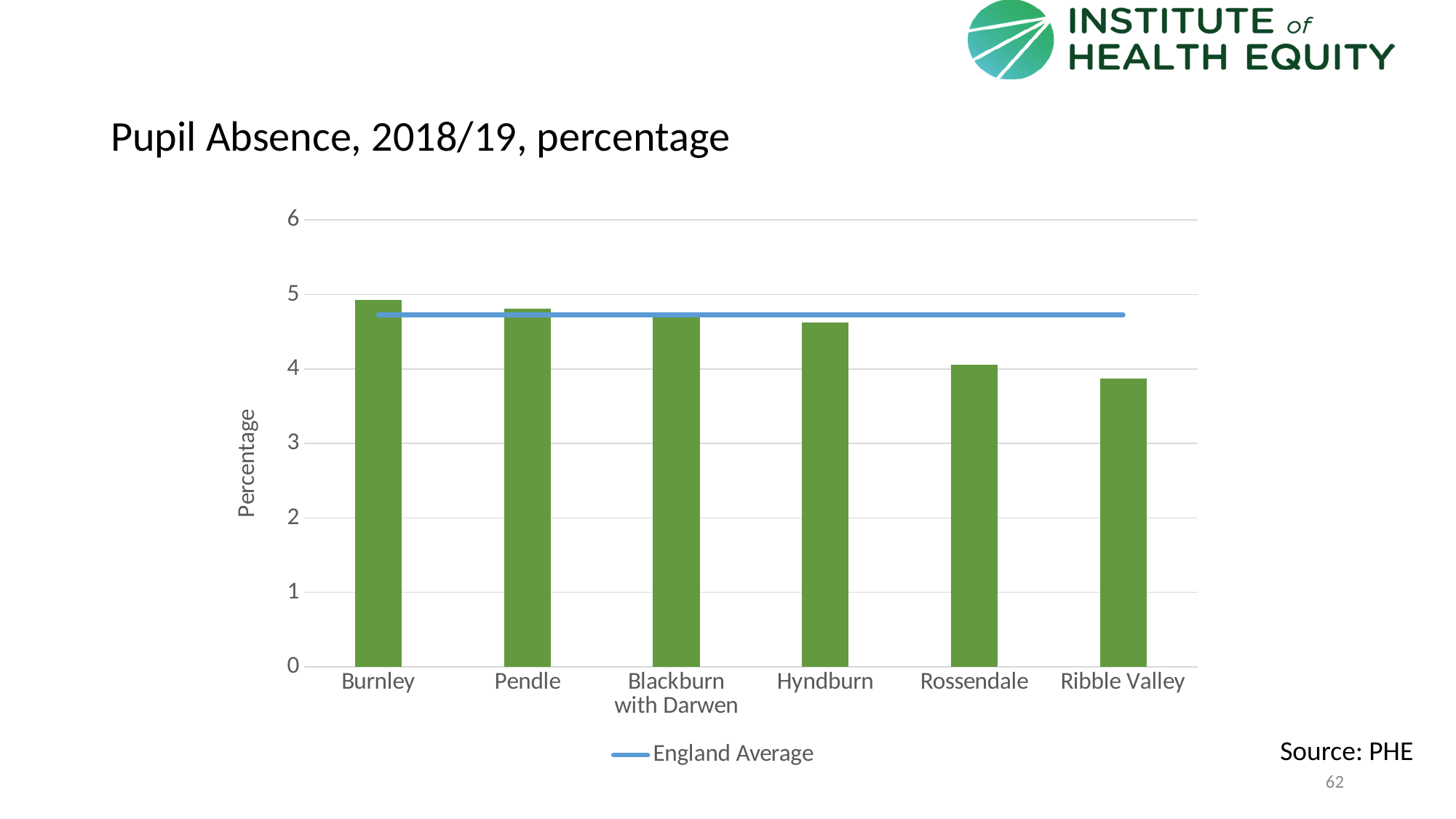
Which is larger, the value for Hyndburn or the value for Rossendale? Hyndburn Which area has the lowest pupil absence percentage? Ribble Valley Is the value for Ribble Valley greater or less than 4? less Is the value for Burnley greater or less than 5? less Do the bar values rise or fall from left to right along the x axis? Fall How many local areas are shown on the x axis of the chart? 6 What kind of chart is shown on the slide? Bar chart Which is larger, the value for Burnley or the value for Ribble Valley? Burnley Is the value for Hyndburn greater or less than 4? greater What does the blue horizontal line in the chart represent, according to the legend? England Average Which area has the highest pupil absence percentage? Burnley